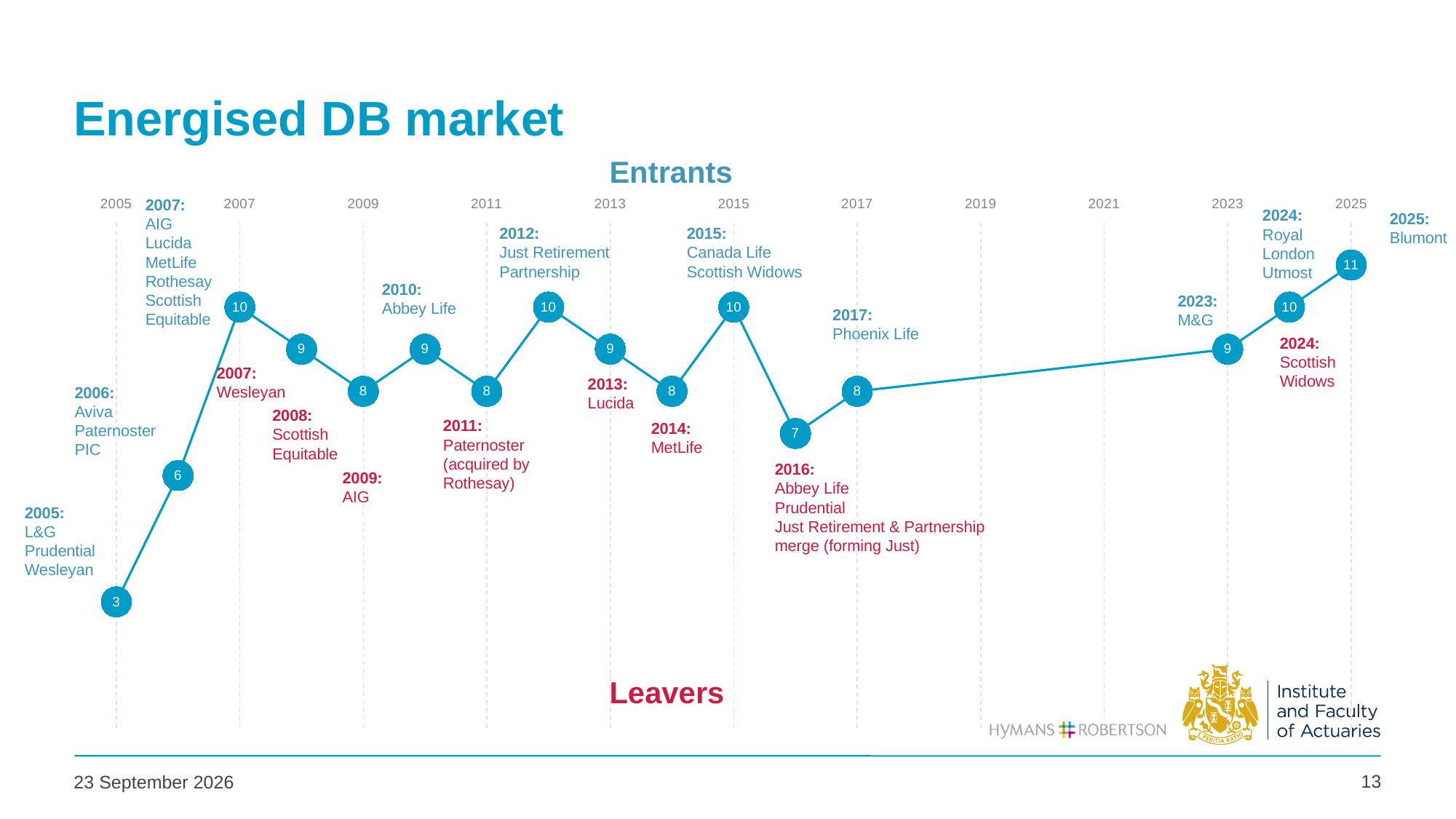
What is the difference between the values for 2025 and 2016? 4 What value is plotted for 2005? 3 Which year has the highest plotted value? 2025 Which is larger, the value for 2015 or the value for 2016? 2015 Which year has the lowest plotted value? 2005 What value is plotted for 2025? 11 What kind of chart is shown on the slide? Line chart What is the difference between the values for 2007 and 2005? 7 Does the plotted value rise or fall from 2023 to 2025? Rise How many data points are plotted on the line? 16 What value is plotted for 2016? 7 What value is plotted for 2012? 10